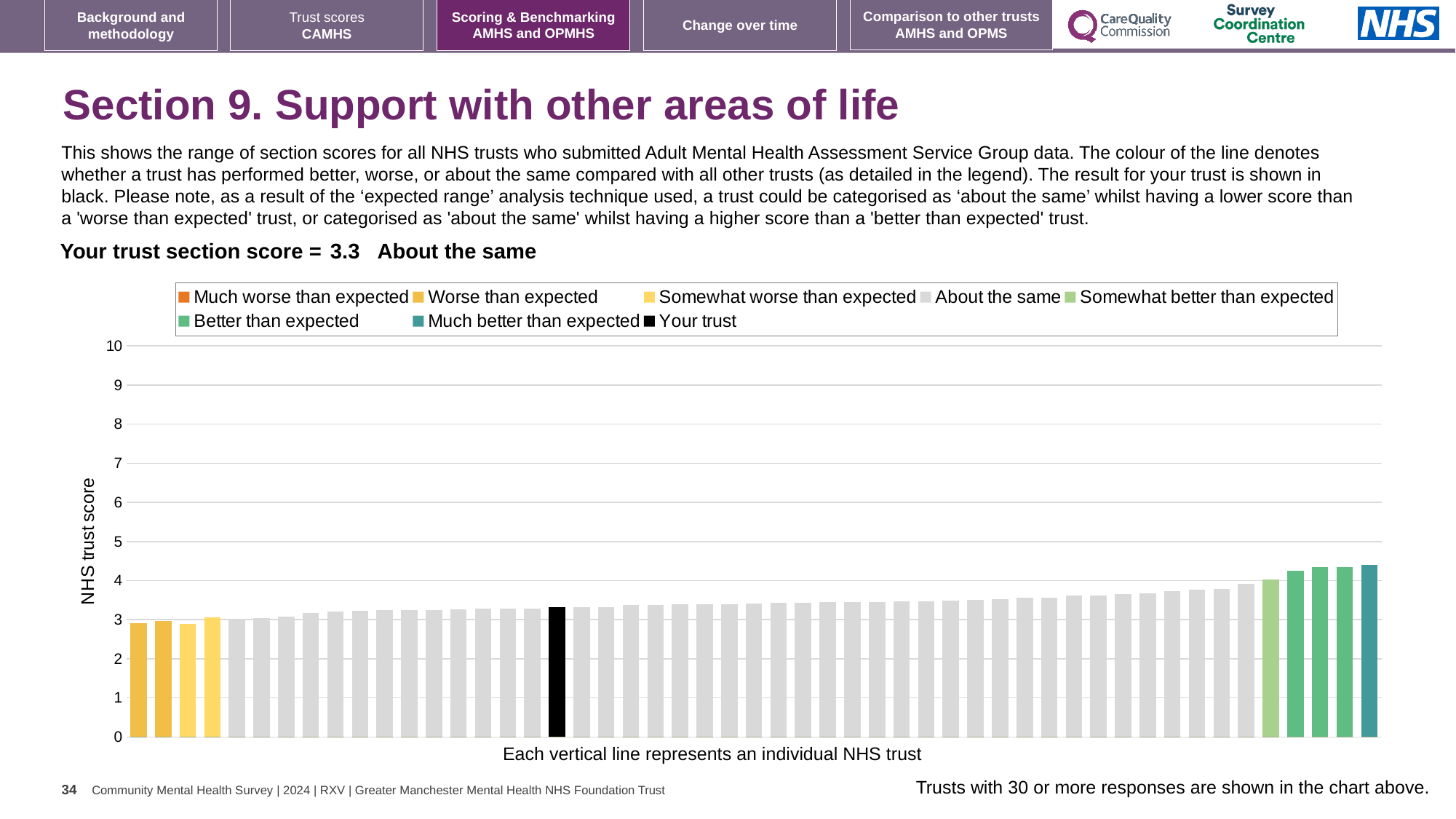
Which legend category does the tallest bar belong to? Much better than expected How many bars are coloured as 'Much worse than expected'? 0 Is the value for your trust (the black bar) greater or less than 4? less What kind of chart is shown on the slide? bar chart How many entries does the chart legend list? 8 Is the value of the tallest bar greater or less than 5? less Which is larger: the value for your trust or the value of the rightmost bar? the rightmost bar What is the section score for your trust? 3.3 Do the bar values rise or fall from left to right along the x axis? rise Is the value of the tallest bar greater or less than 4? greater Which performance category is your trust placed in? About the same What is the label on the y axis of the chart? NHS trust score